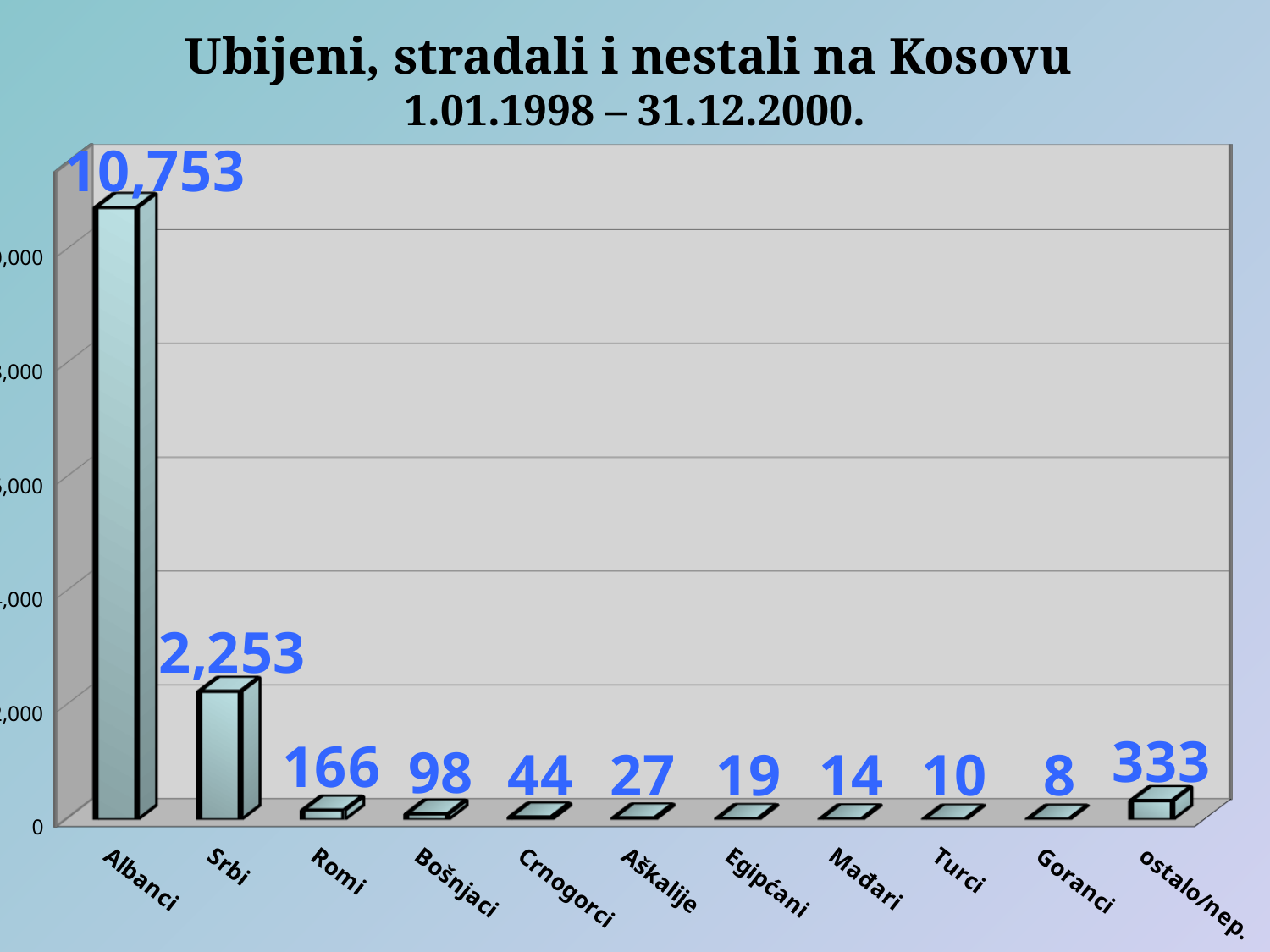
What is the value for Romi? 166 What kind of chart is shown on the slide? bar chart What is the value for Albanci? 10,753 Which is larger, the value for ostalo/nep. or the value for Romi? ostalo/nep. What is the value for Srbi? 2,253 Which category has the highest value? Albanci What is the value for ostalo/nep.? 333 Which category has the lowest value? Goranci What is the title of the chart? Ubijeni, stradali i nestali na Kosovu 1.01.1998 – 31.12.2000. What is the difference between the values for Romi and Bošnjaci? 68 How many categories are shown on the x axis? 11 What is the difference between the values for Albanci and Srbi? 8,500